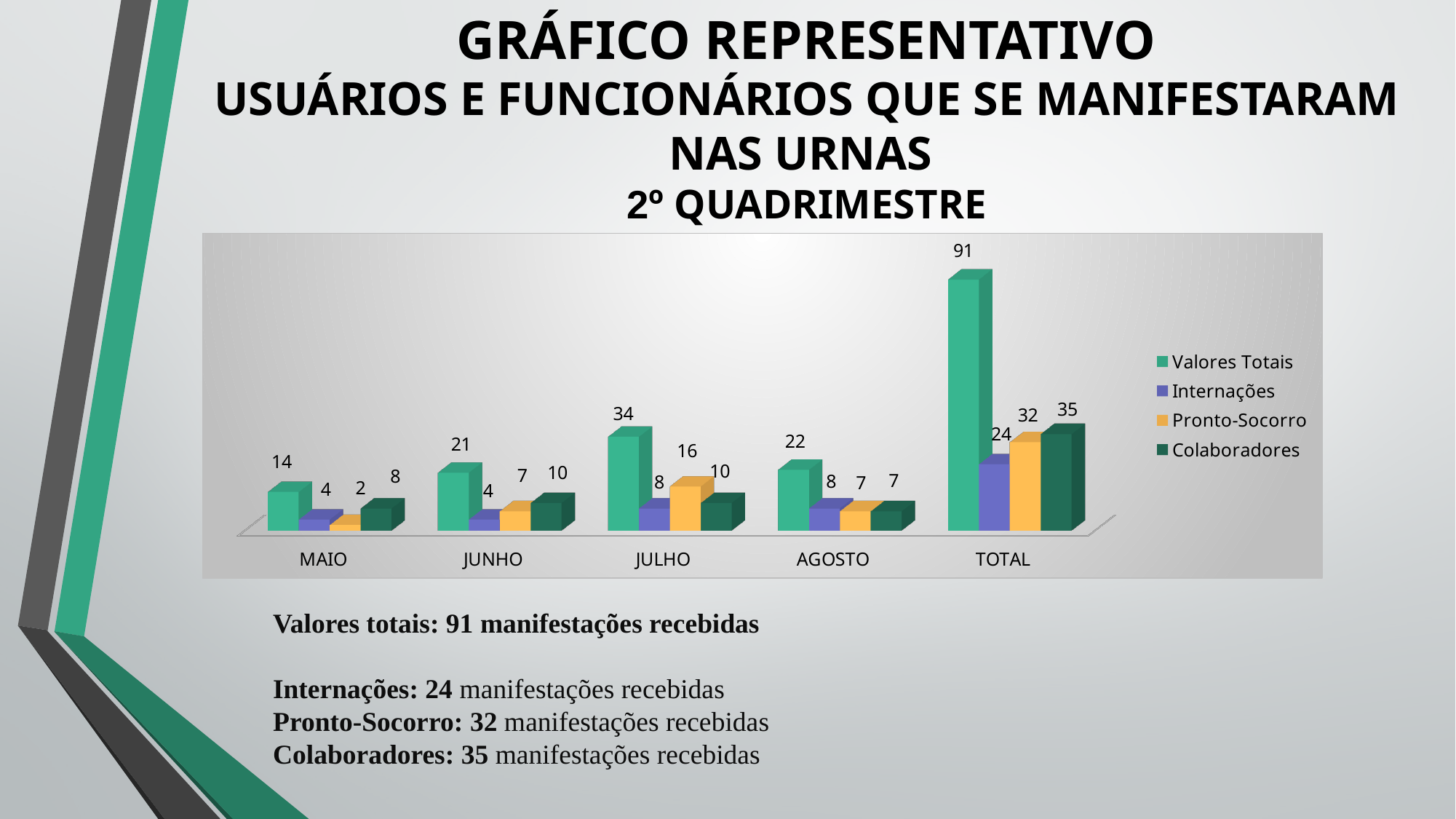
How many series does the legend list? 4 Which is larger: Pronto-Socorro for JULHO or Colaboradores for JULHO? Pronto-Socorro for JULHO What is the value of Colaboradores for TOTAL? 35 Which series is shown in yellow/orange in the legend? Pronto-Socorro Which category has the lowest Pronto-Socorro value? MAIO What is the difference between Valores Totais for JULHO and for MAIO? 20 What is the value of Internações for AGOSTO? 8 What kind of chart is shown on the slide? Bar chart Which month (excluding TOTAL) has the highest Valores Totais? JULHO What is the value of Valores Totais for JULHO? 34 How many categories are shown on the x axis? 5 What is the value of Pronto-Socorro for JUNHO? 7